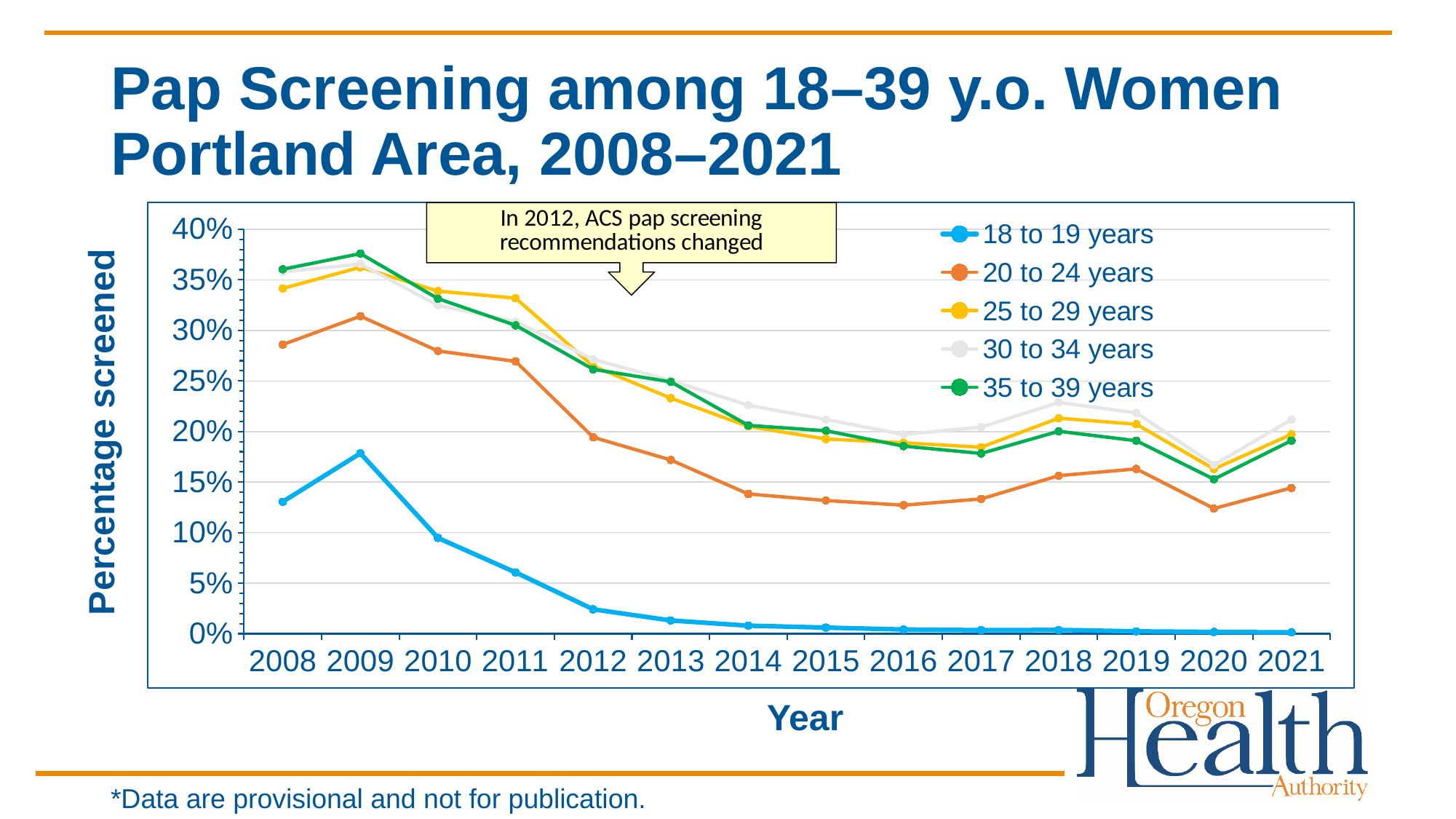
Is the value for 20 to 24 years in 2020 greater or less than 15%? less In which year is the value for 18 to 19 years highest? 2009 Does the value for 18 to 19 years rise or fall from 2009 to 2021? fall Is the value for 18 to 19 years in 2008 greater or less than 15%? less How many years are plotted along the x axis? 14 Is the value for 35 to 39 years in 2009 greater or less than 35%? greater What kind of chart is shown on the slide? line chart What is the title of the y axis? Percentage screened According to the annotation on the chart, in which year did ACS pap screening recommendations change? 2012 In 2009, which is larger: the value for 18 to 19 years or the value for 20 to 24 years? 20 to 24 years Which age group has the lowest value in 2021? 18 to 19 years How many series does the legend list? 5